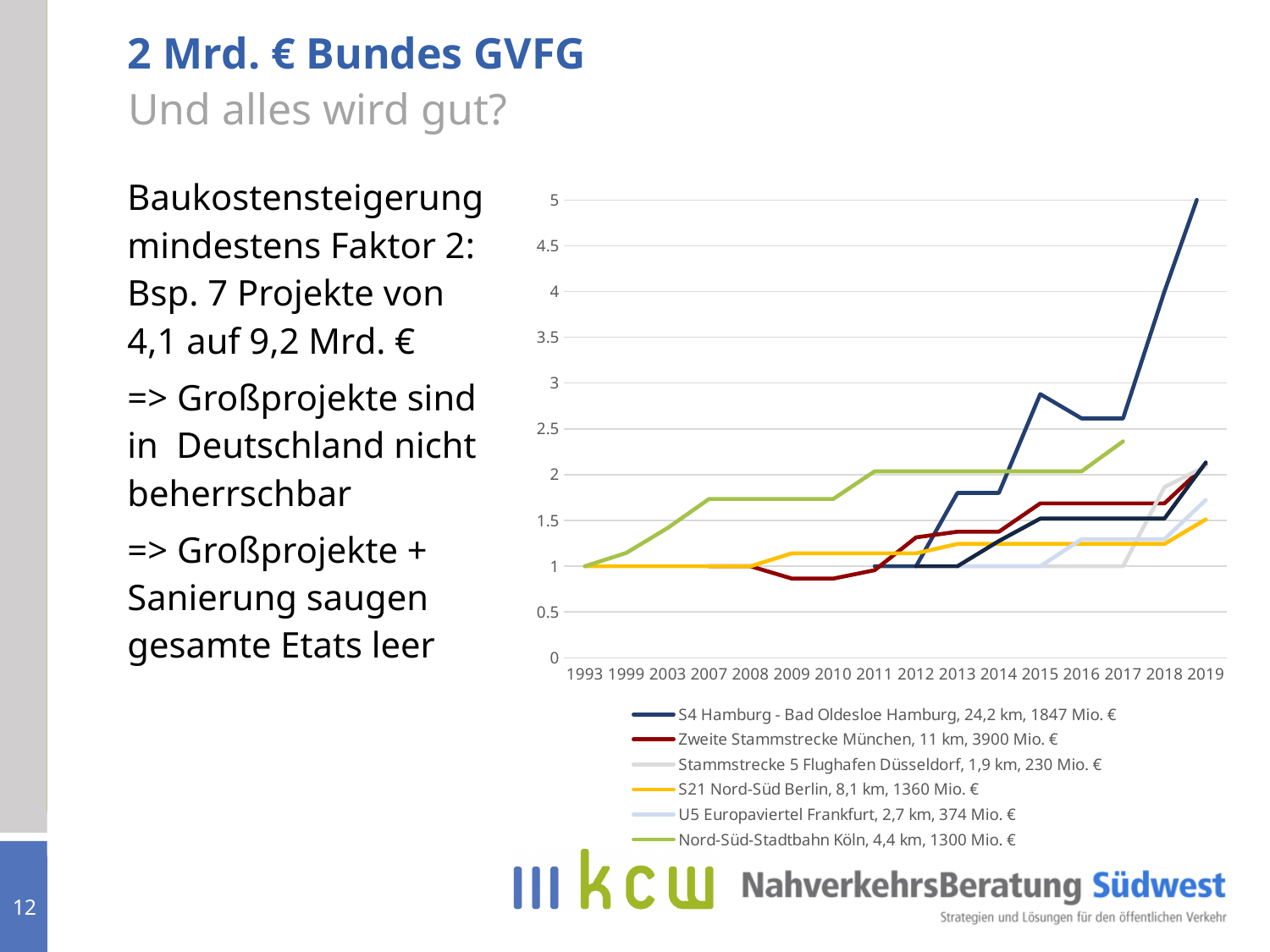
Which series is the only one that dips below 1 on the chart? Zweite Stammstrecke München, 11 km, 3900 Mio. € Does the S4 Hamburg - Bad Oldesloe Hamburg line rise or fall from 2012 to 2019? rise What colour is the line for S4 Hamburg - Bad Oldesloe Hamburg in the chart? dark blue How many years are shown along the x axis of the chart? 16 What kind of chart is shown on the slide? line chart Is the value for Nord-Süd-Stadtbahn Köln in 2017 greater or less than 2? greater In 2015, which is larger: the value for S4 Hamburg - Bad Oldesloe Hamburg or the value for Zweite Stammstrecke München? S4 Hamburg - Bad Oldesloe Hamburg Which series reaches the highest value on the chart in 2019? S4 Hamburg - Bad Oldesloe Hamburg, 24,2 km, 1847 Mio. € How many series does the chart's legend list? 6 Is the value for Zweite Stammstrecke München in 2010 greater or less than 1? less According to the legend, how long is the Zweite Stammstrecke München project? 11 km Is the value for S4 Hamburg - Bad Oldesloe Hamburg in 2019 greater or less than 4.5? greater